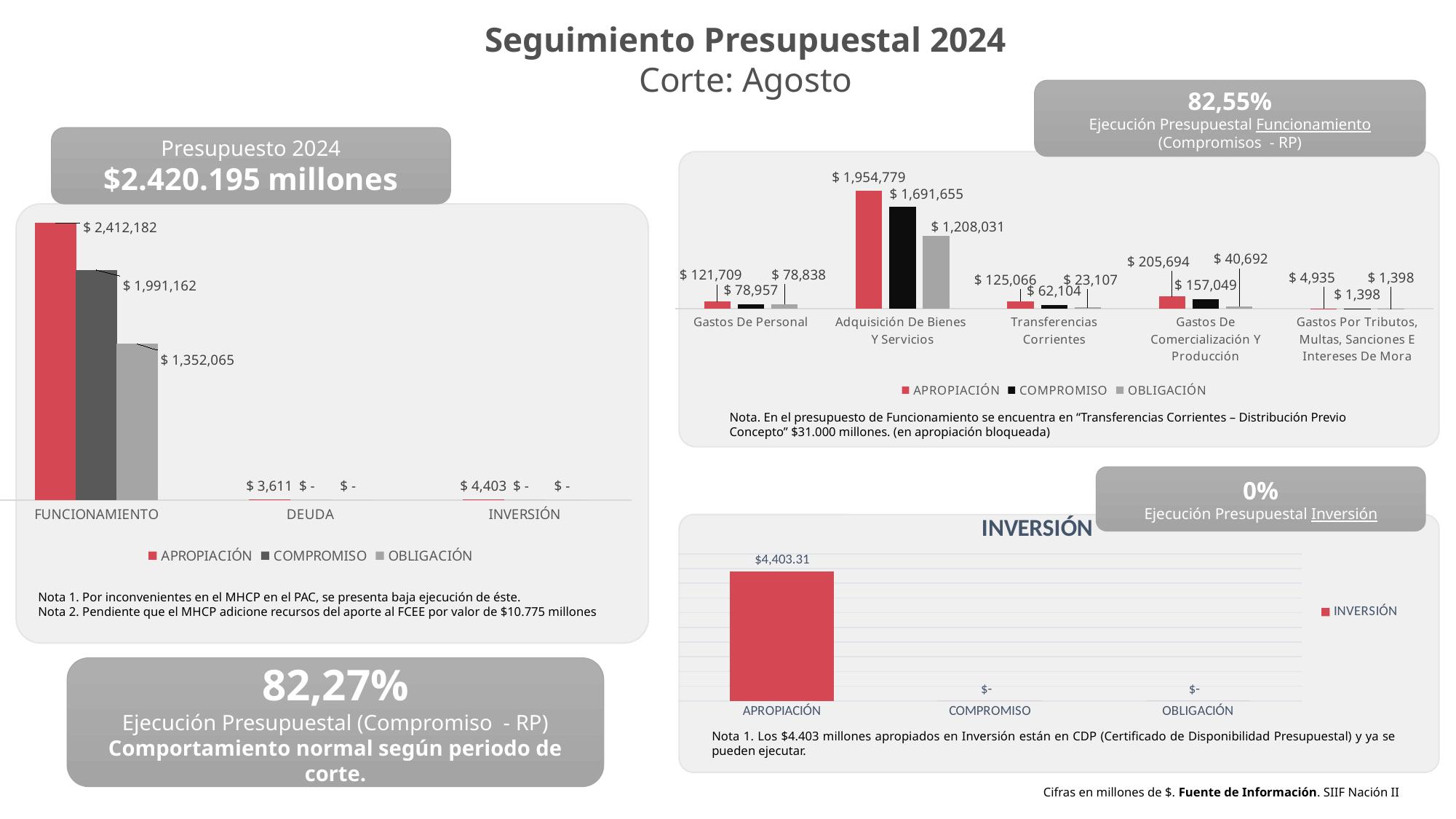
In the left chart (Presupuesto 2024), what is the difference between the APROPIACIÓN and COMPROMISO values for FUNCIONAMIENTO? 421,020 In the bottom-right chart (INVERSIÓN), what is the value for APROPIACIÓN? $4,403.31 In the left chart (Presupuesto 2024), what is the OBLIGACIÓN value for FUNCIONAMIENTO? $ 1,352,065 In the left chart (Presupuesto 2024), which category has the highest APROPIACIÓN value? FUNCIONAMIENTO In the top-right chart (Funcionamiento breakdown), what is the COMPROMISO value for Adquisición De Bienes Y Servicios? $ 1,691,655 In the top-right chart (Funcionamiento breakdown), what is the OBLIGACIÓN value for Transferencias Corrientes? $ 23,107 In the top-right chart (Funcionamiento breakdown), is the APROPIACIÓN value for Gastos De Comercialización Y Producción larger or smaller than that for Transferencias Corrientes? larger What kind of chart is the bottom-right chart (INVERSIÓN)? bar chart In the top-right chart (Funcionamiento breakdown), how many categories are shown on the x axis? 5 In the left chart (Presupuesto 2024), what is the APROPIACIÓN value for FUNCIONAMIENTO? $ 2,412,182 In the top-right chart (Funcionamiento breakdown), which category has the lowest APROPIACIÓN value? Gastos Por Tributos, Multas, Sanciones E Intereses De Mora In the left chart (Presupuesto 2024), how many series does the legend list? 3